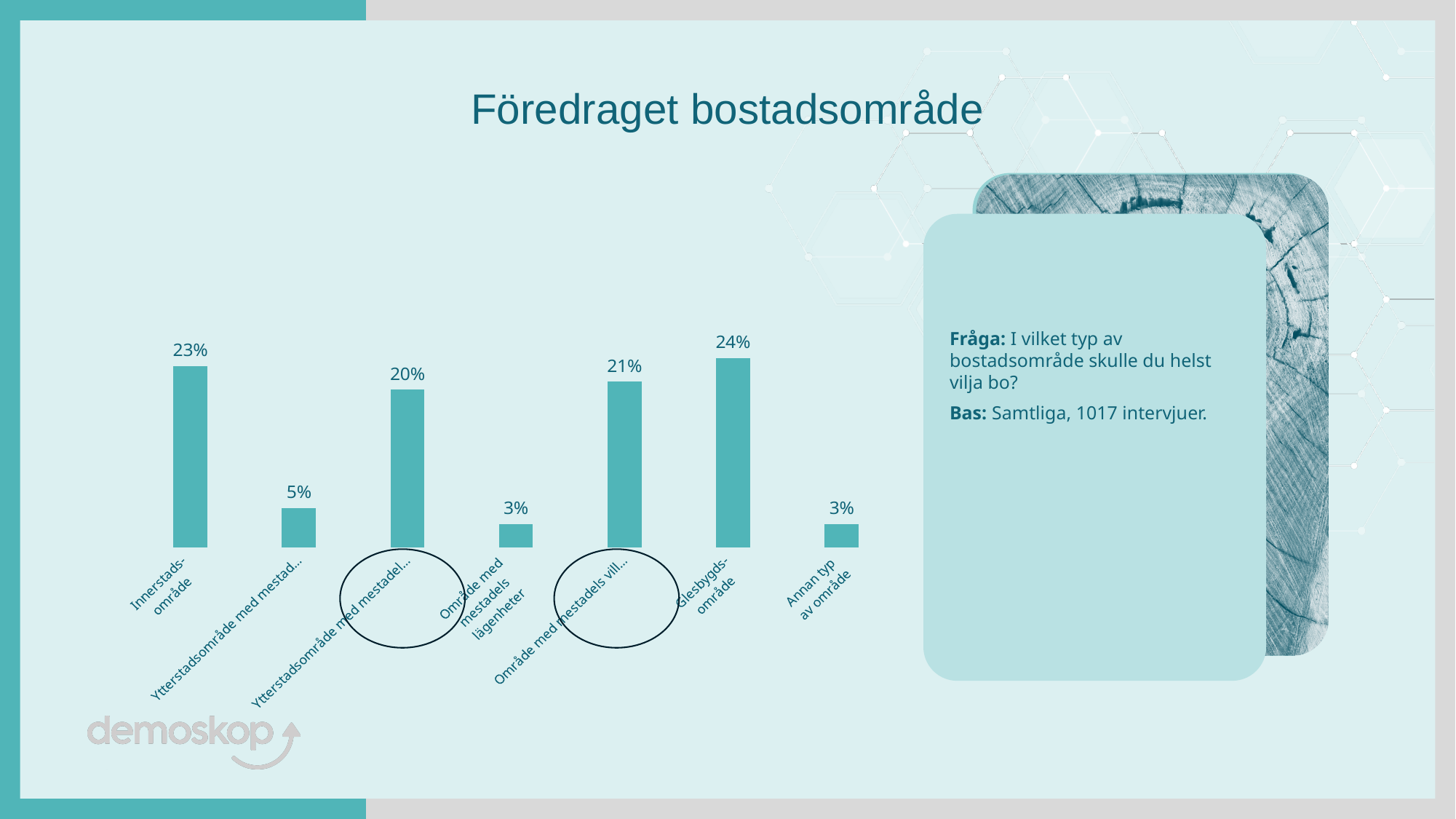
What is the value for Annan typ av område? 3% What is the title of the slide? Föredraget bostadsområde What kind of chart is shown on the slide? Bar chart What is the value for Område med mestadels lägenheter? 3% How many categories have a value of 3%? 2 Which category has the highest value? Glesbygdsområde What is the value of the second bar from the left (Ytterstadsområde med mestad...)? 5% How many categories are shown in the chart? 7 What is the difference between the values for Glesbygdsområde and Innerstadsområde? 1% What is the value for Glesbygdsområde? 24% Which is larger, the value for Innerstadsområde or the value for Annan typ av område? Innerstadsområde What is the value for Innerstadsområde? 23%